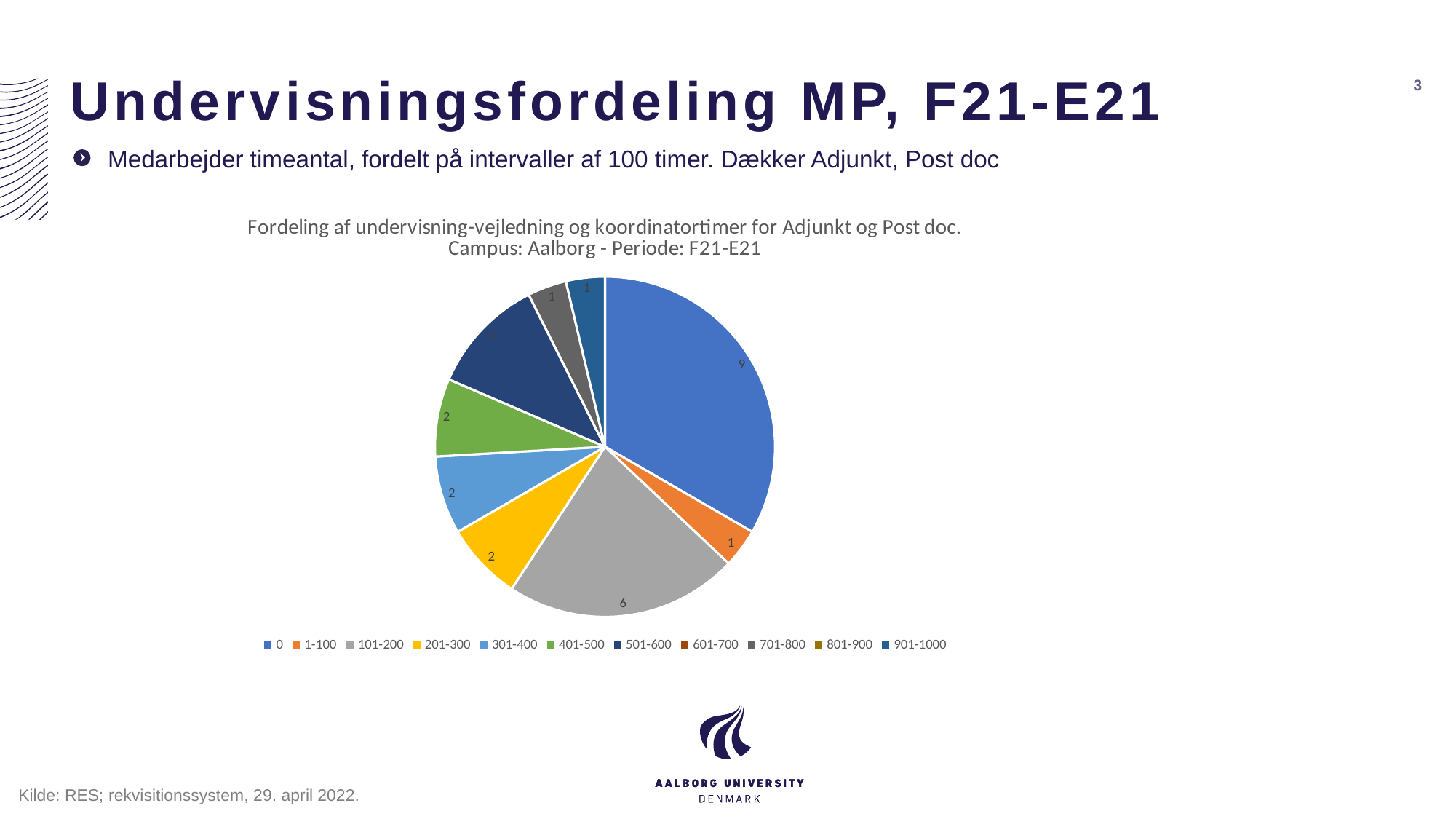
What is the value shown for the 101-200 slice? 6 What kind of chart is shown on the slide? pie chart How many categories does the legend list? 11 What is the value shown for the 0 slice? 9 What is the difference between the value for 0 and the value for 101-200? 3 Which is larger, the slice for 0 or the slice for 101-200? 0 What is the value shown for the 401-500 slice? 2 What is the second line of the chart title? Campus: Aalborg - Periode: F21-E21 What is the value shown for the 201-300 slice? 2 Which category has the largest slice of the pie? 0 What is the value shown for the 1-100 slice? 1 Which is larger, the slice for 101-200 or the slice for 1-100? 101-200